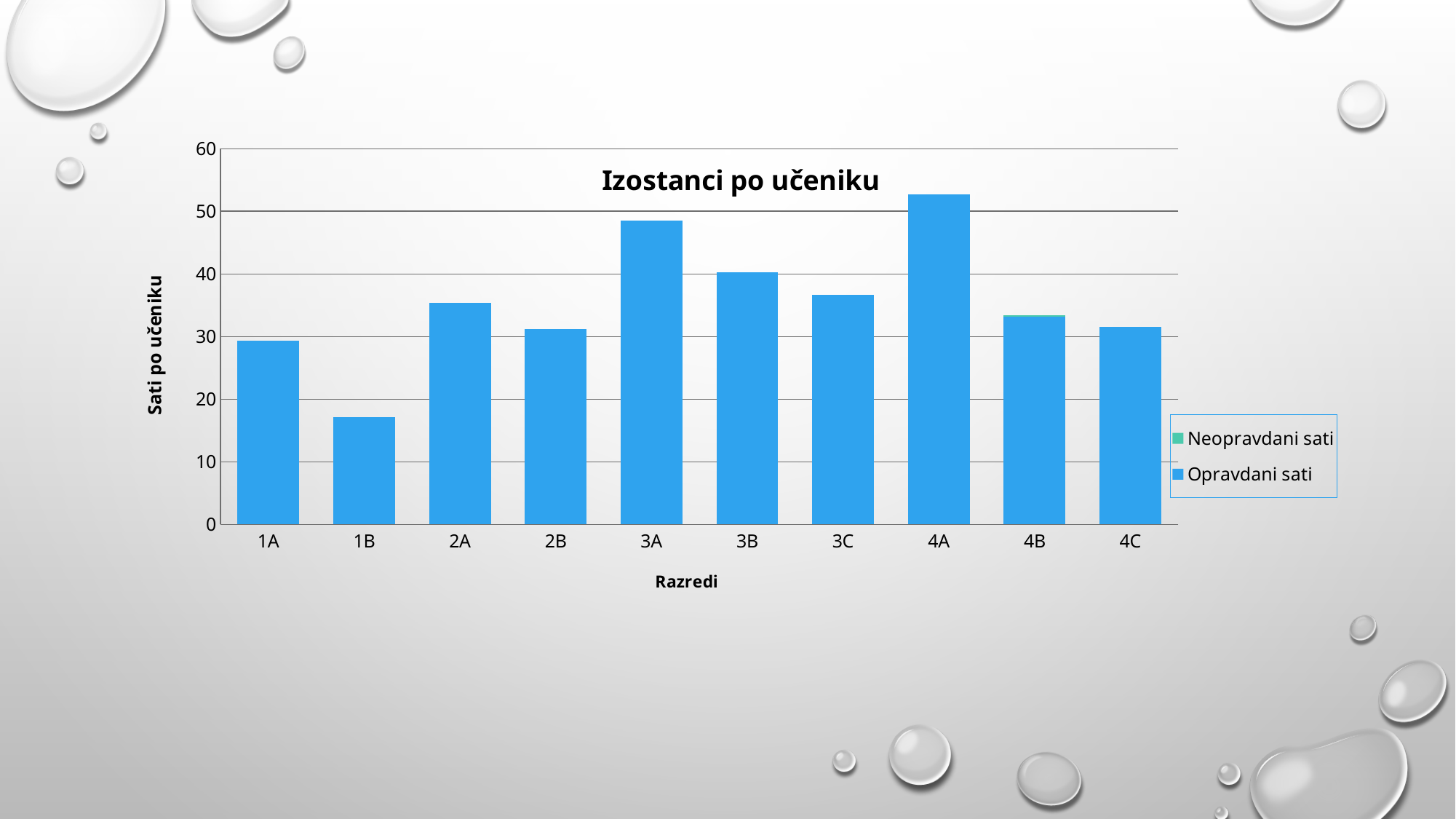
What is the label of the x axis? Razredi Is the value for 3A greater or less than 40? greater How many series does the legend list? 2 Which class has the lowest bar? 1B How many classes (categories) are shown on the x axis? 10 Which bar is taller, 2A or 2B? 2A What is the title of the chart? Izostanci po učeniku Which bar is taller, 3A or 3B? 3A Is the value for 4A greater or less than 50? greater What kind of chart is shown on the slide? bar chart Is the value for 1B greater or less than 20? less Which class has the highest bar? 4A